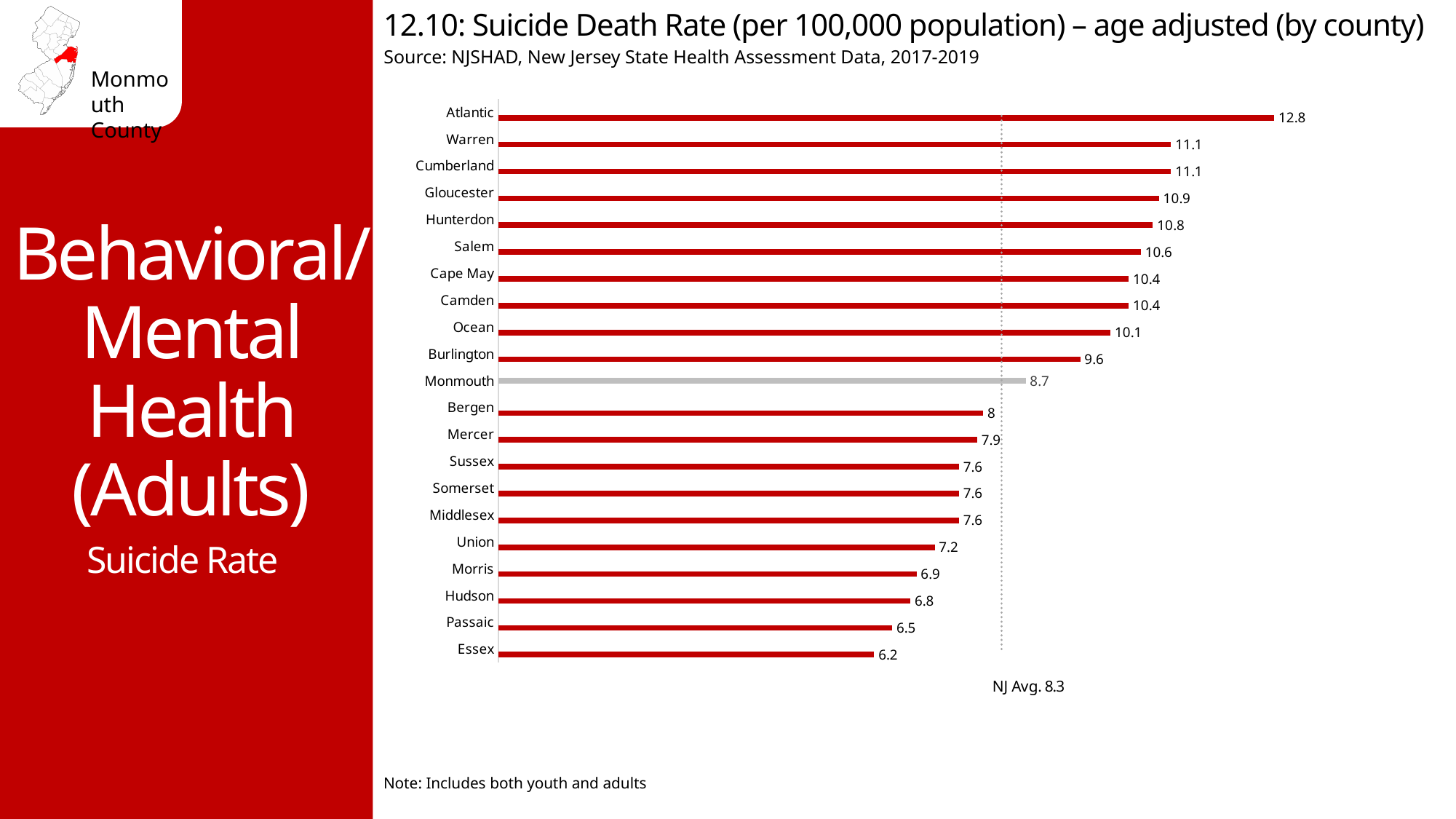
How many counties are shown in the chart? 21 What is the suicide death rate for Essex County? 6.2 Which county's bar is shown in gray instead of red? Monmouth Which county has the lowest suicide death rate? Essex What is the suicide death rate for Atlantic County? 12.8 Which county has the highest suicide death rate? Atlantic What is the NJ average suicide death rate shown on the chart? 8.3 What is the difference between the suicide death rates of Atlantic and Monmouth counties? 4.1 What is the suicide death rate for Hunterdon County? 10.8 What is the suicide death rate for Monmouth County? 8.7 What type of chart is used on this slide? Bar chart Which county has a higher suicide death rate, Ocean or Bergen? Ocean